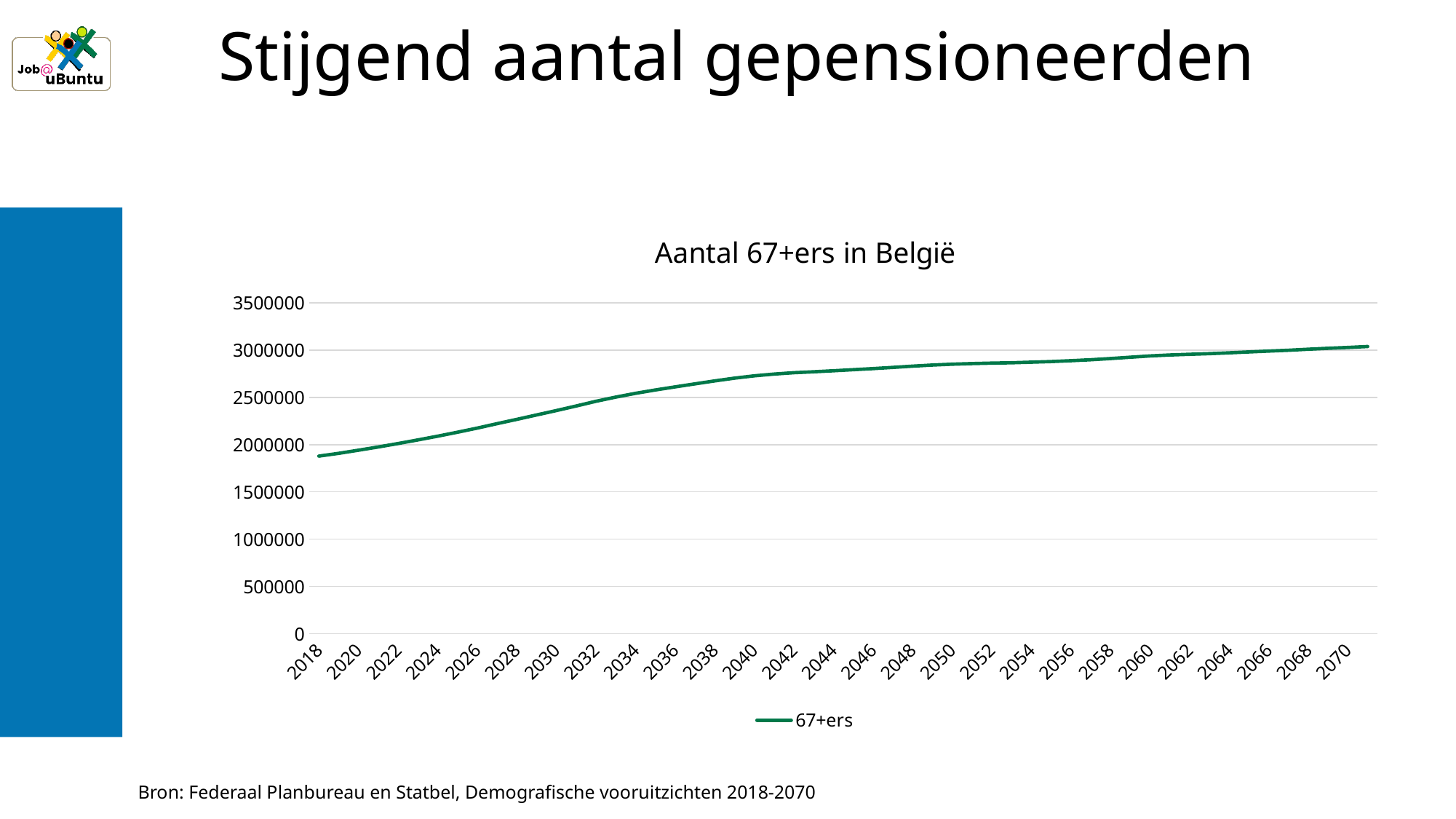
Is the value for 2018 greater or less than 2000000? less In which year is the number of 67+ers lowest? 2018 Is the value for 2030 greater or less than 2500000? less Is the value for 2040 greater or less than 2500000? greater How many year labels are shown on the x axis? 27 What is the title of the chart? Aantal 67+ers in België Do the values rise or fall from 2018 to 2070? rise What kind of chart is shown on the slide? line chart How many series does the legend list? 1 What is the name of the series shown in the legend? 67+ers